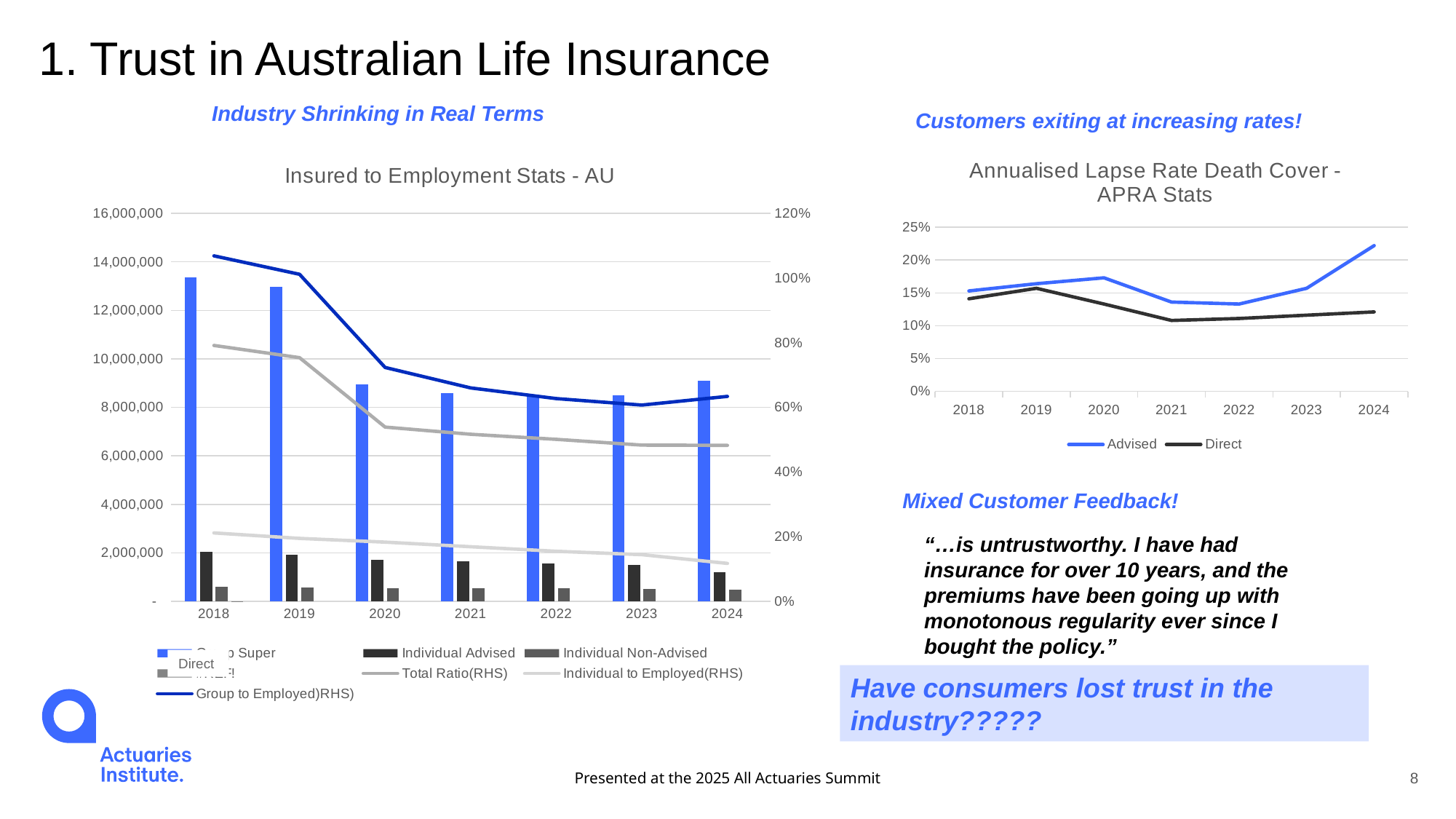
On the 'Annualised Lapse Rate Death Cover - APRA Stats' chart, is the Advised value for 2024 greater or less than 20%? greater On the 'Insured to Employment Stats - AU' chart, is the Group to Employed (RHS) value for 2018 greater or less than 100%? greater On the 'Insured to Employment Stats - AU' chart, is the Group Super value for 2018 greater or less than 12,000,000? greater On the 'Annualised Lapse Rate Death Cover - APRA Stats' chart, in which year is the Advised lapse rate highest? 2024 On the 'Insured to Employment Stats - AU' chart, in which year is the Group Super bar highest? 2018 On the 'Insured to Employment Stats - AU' chart, does the Group to Employed (RHS) line generally rise or fall from 2018 to 2024? fall How many series does the legend of the 'Annualised Lapse Rate Death Cover - APRA Stats' chart list? 2 How many years are shown on the x axis of the 'Annualised Lapse Rate Death Cover - APRA Stats' chart? 7 On the 'Annualised Lapse Rate Death Cover - APRA Stats' chart, which series is higher in 2024, Advised or Direct? Advised On the 'Insured to Employment Stats - AU' chart, which bar is taller in 2024, Individual Advised or Individual Non-Advised? Individual Advised What kind of chart is the 'Annualised Lapse Rate Death Cover - APRA Stats' chart? line chart